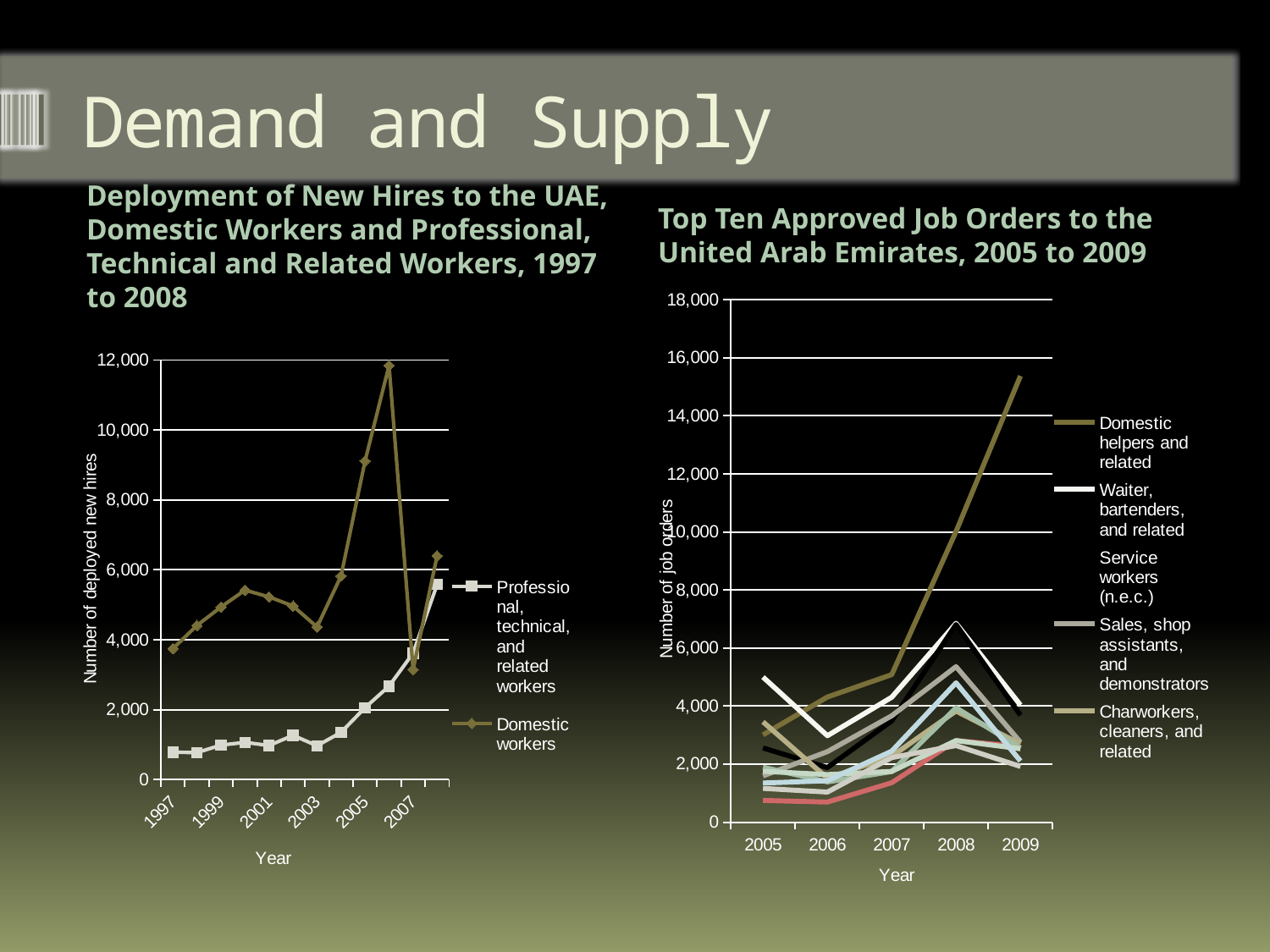
In the left chart, 'Deployment of New Hires to the UAE', do the values for Professional, technical, and related workers generally rise or fall from 2003 to 2008? rise In the left chart, 'Deployment of New Hires to the UAE', which series has the larger value in 2005, Domestic workers or Professional, technical, and related workers? Domestic workers What kind of chart is the left chart, 'Deployment of New Hires to the UAE'? line chart In the right chart, 'Top Ten Approved Job Orders to the United Arab Emirates', which series has the highest value in 2009? Domestic helpers and related In the left chart, 'Deployment of New Hires to the UAE', in which year do Domestic workers reach their highest value? 2006 What is the y-axis label of the right chart, 'Top Ten Approved Job Orders to the United Arab Emirates'? Number of job orders In the right chart, 'Top Ten Approved Job Orders to the United Arab Emirates', is the value for Domestic helpers and related in 2009 greater or less than 14,000? greater How many years are plotted on the x axis of the right chart, 'Top Ten Approved Job Orders to the United Arab Emirates'? 5 In the left chart, 'Deployment of New Hires to the UAE', is the value for Domestic workers in 2006 greater or less than 10,000? greater How many series does the legend of the left chart, 'Deployment of New Hires to the UAE', list? 2 In the right chart, 'Top Ten Approved Job Orders to the United Arab Emirates', do the values for Domestic helpers and related rise or fall from 2005 to 2009? rise In the left chart, 'Deployment of New Hires to the UAE', is the value for Professional, technical, and related workers in 1997 greater or less than 2,000? less